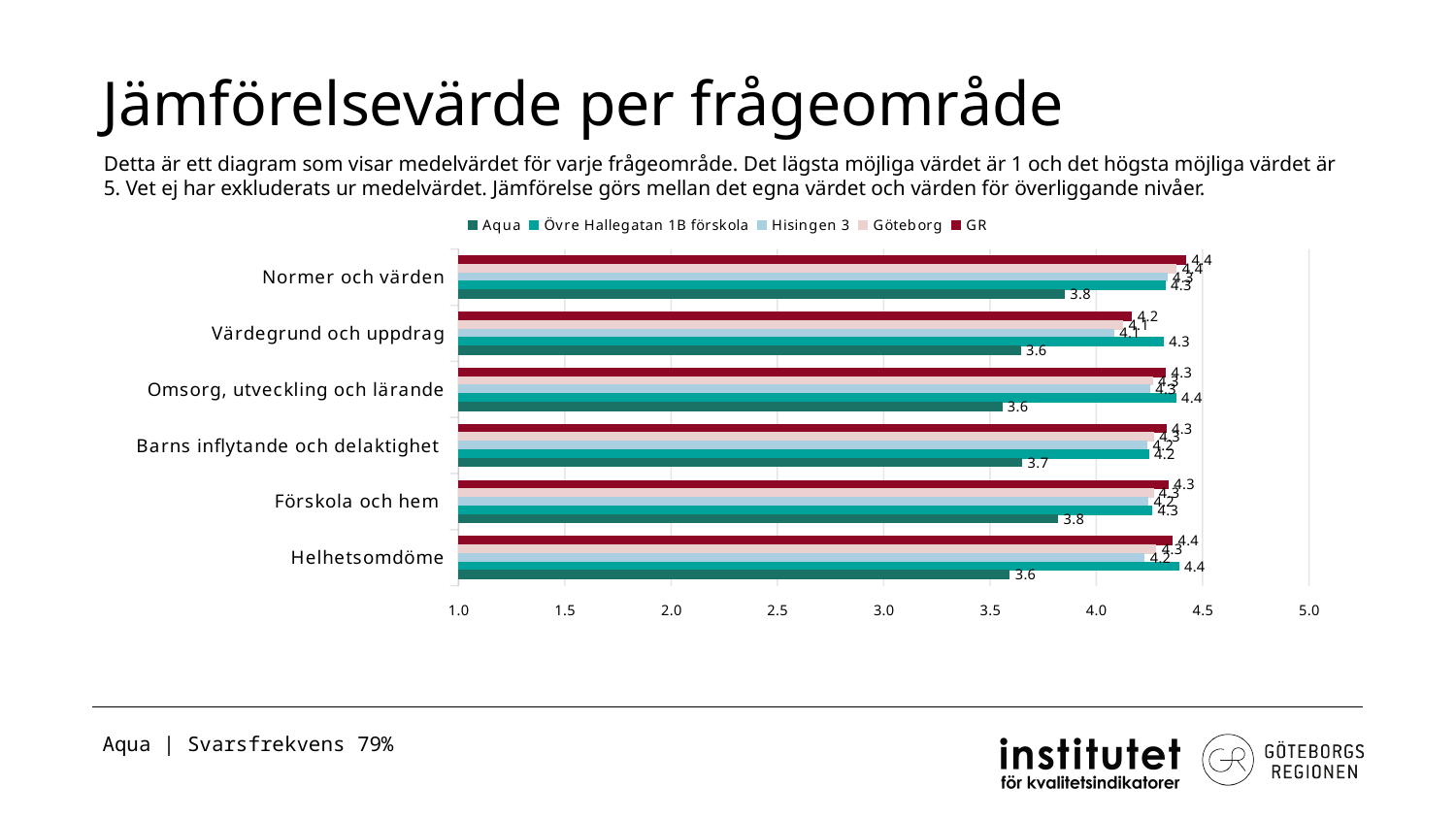
Is the Aqua value for Omsorg, utveckling och lärande greater or less than 4.0? less How many categories (frågeområden) are shown on the y axis? 6 What is the value for Aqua in the category Normer och värden? 3.8 For the Aqua series, which is larger: the value for Normer och värden or the value for Helhetsomdöme? Normer och värden What kind of chart is shown on the slide? bar chart In the category Normer och värden, which series has the lowest value? Aqua What is the value for Aqua in the category Förskola och hem? 3.8 What is the value for Övre Hallegatan 1B förskola in the category Helhetsomdöme? 4.4 What is the difference between the Övre Hallegatan 1B förskola value and the Aqua value in the category Omsorg, utveckling och lärande? 0.8 What is the difference between the Övre Hallegatan 1B förskola value and the Aqua value in the category Värdegrund och uppdrag? 0.7 How many series does the legend list? 5 What is the value for Aqua in the category Barns inflytande och delaktighet? 3.7